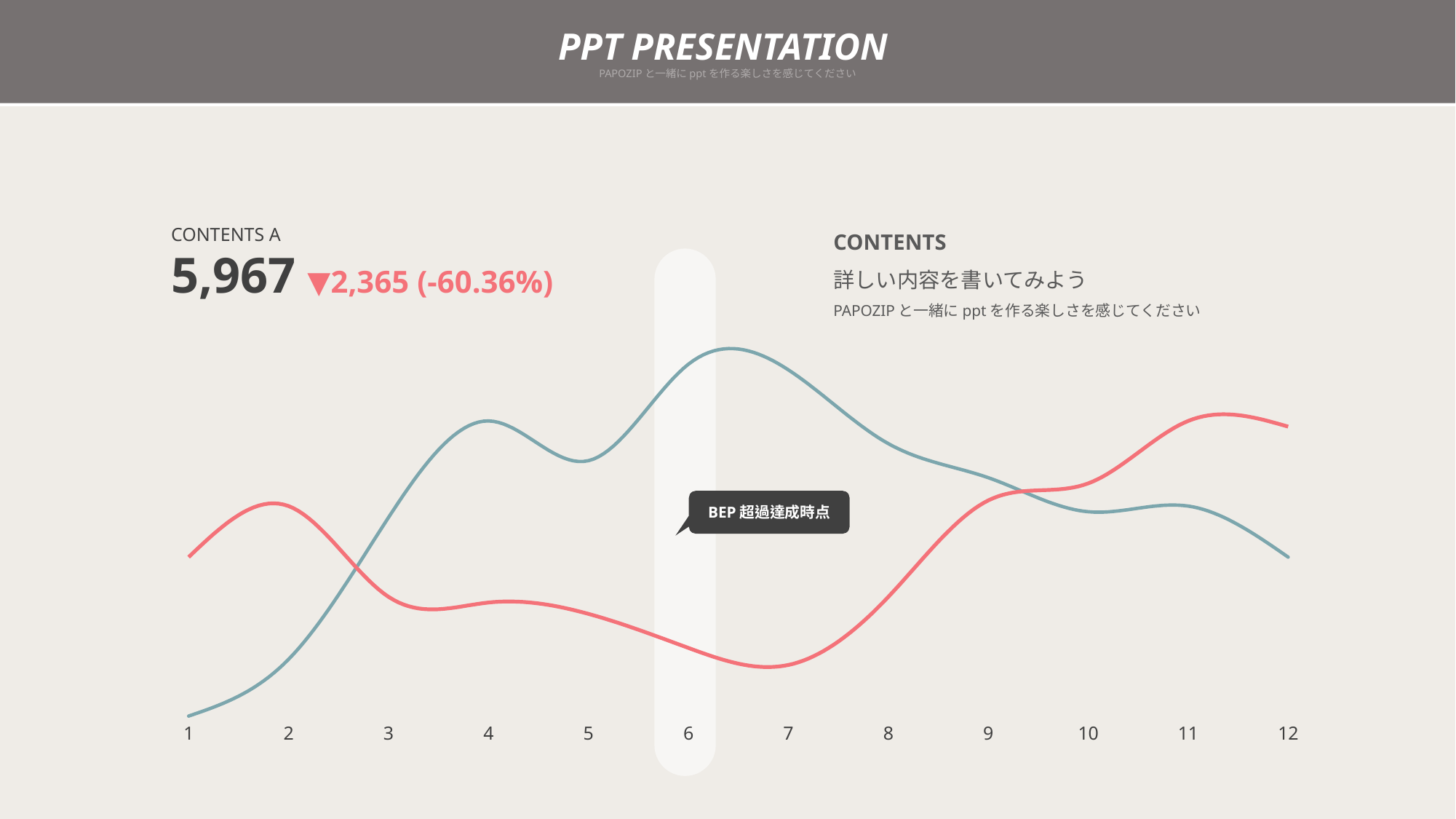
At x = 12, which line is higher, the blue line or the red line? the red line Which x-axis label is highlighted by the vertical shaded band on the chart? 6 At which x-axis label does the red line reach its lowest point? 7 What text is shown in the callout label placed on the chart? BEP 超過達成時点 At x = 2, which line is higher, the blue line or the red line? the red line Does the blue line rise or fall from x = 1 to x = 4? rise How many lines are plotted on the chart? 2 How many points are labelled along the x axis of the chart? 12 At x = 6, which line is higher, the blue line or the red line? the blue line At which x-axis label does the blue line reach its lowest point? 1 Does the red line rise or fall from x = 7 to x = 11? rise What kind of chart is shown on the slide? line chart